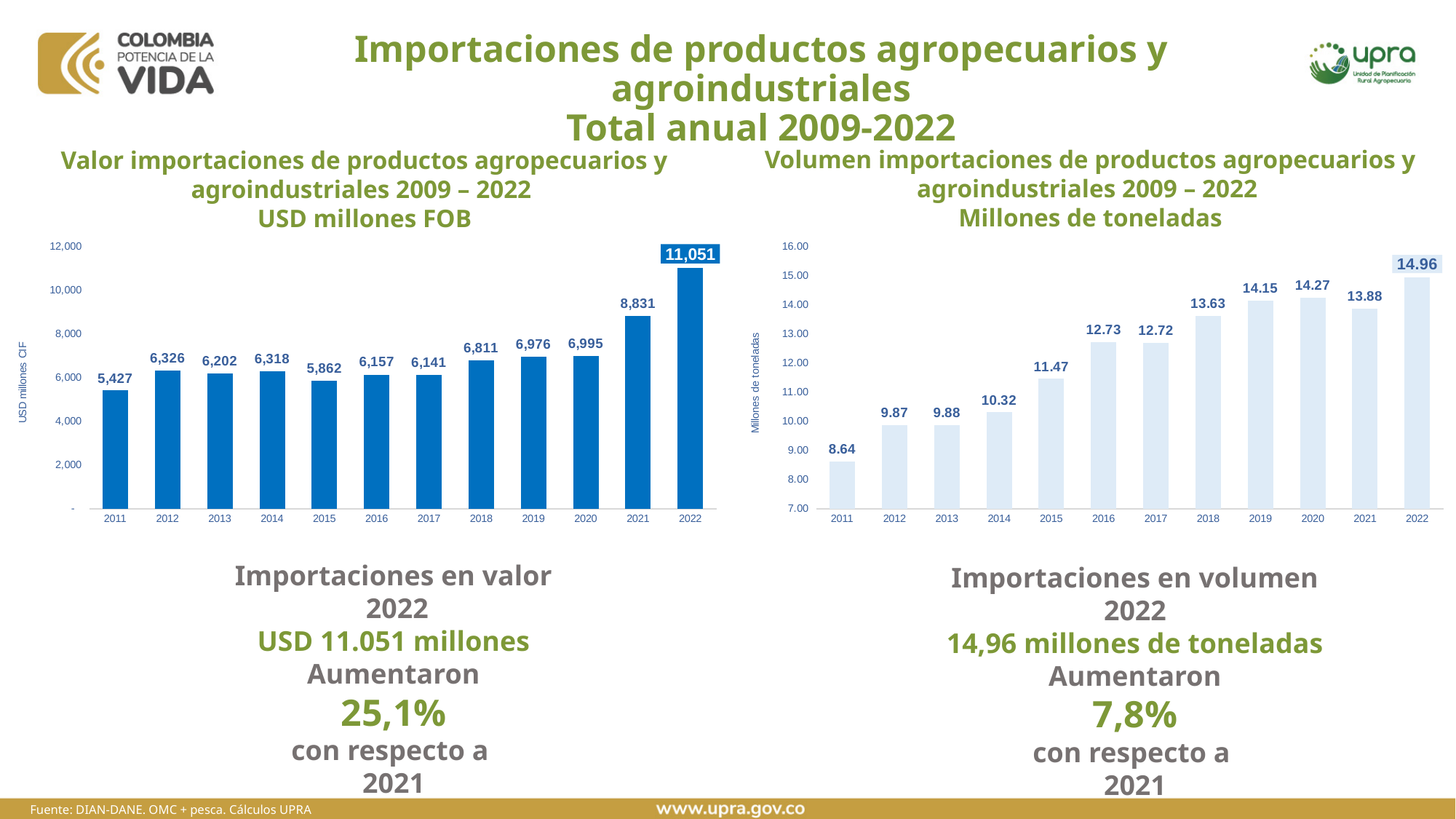
What type of chart is the left chart (Valor importaciones, USD millones FOB)? Bar chart What is the y-axis label of the right chart (Volumen importaciones)? Millones de toneladas In the left chart (Valor importaciones, USD millones FOB), what is the difference between the 2022 and 2021 values? 2,220 In the left chart (Valor importaciones, USD millones FOB), which year has the lowest value? 2011 In the right chart (Volumen importaciones, Millones de toneladas), what is the difference between the 2022 and 2021 values? 1.08 In the left chart (Valor importaciones, USD millones FOB), how many years are plotted? 12 In the right chart (Volumen importaciones, Millones de toneladas), what is the value for 2019? 14.15 In the left chart (Valor importaciones, USD millones FOB), what is the value for 2022? 11,051 In the right chart (Volumen importaciones, Millones de toneladas), which year has the highest value? 2022 In the left chart (Valor importaciones, USD millones FOB), what is the value for 2015? 5,862 In the right chart (Volumen importaciones, Millones de toneladas), which is larger, the value for 2020 or the value for 2021? 2020 In the right chart (Volumen importaciones, Millones de toneladas), what is the value for 2011? 8.64